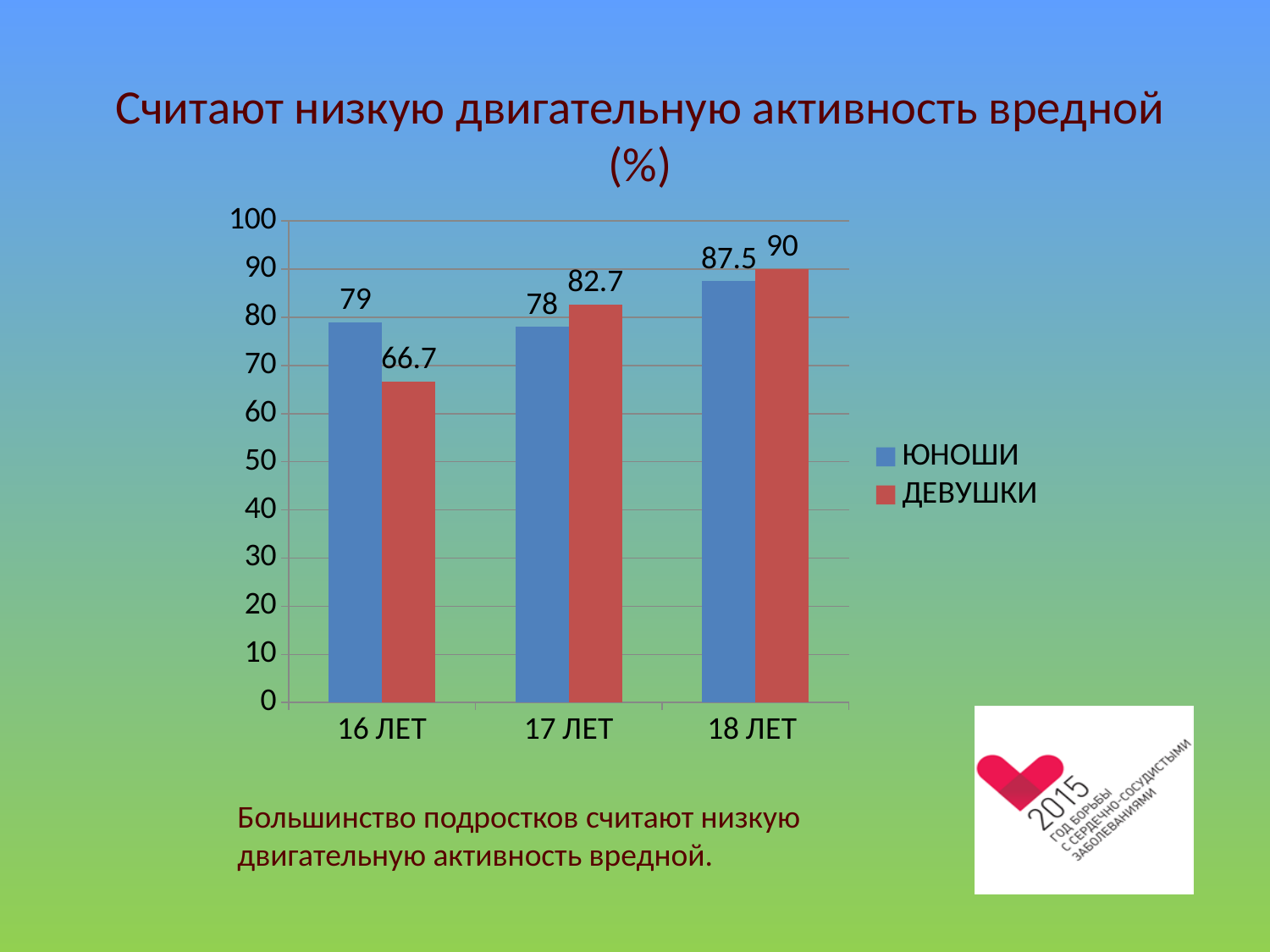
At 18 ЛЕТ, which is larger: the value for ЮНОШИ or for ДЕВУШКИ? ДЕВУШКИ Which age group has the lowest value for ДЕВУШКИ? 16 ЛЕТ What kind of chart is shown on the slide? bar chart Do the ДЕВУШКИ values rise or fall from 16 ЛЕТ to 18 ЛЕТ? rise What is the value for ЮНОШИ at 16 ЛЕТ? 79 Which age group has the highest value for ДЕВУШКИ? 18 ЛЕТ How many age groups are shown on the x axis? 3 What is the difference between the ЮНОШИ and ДЕВУШКИ values at 16 ЛЕТ? 12.3 What is the value for ДЕВУШКИ at 17 ЛЕТ? 82.7 Is the value for ДЕВУШКИ at 16 ЛЕТ greater or less than 70? less What is the value for ДЕВУШКИ at 18 ЛЕТ? 90 How many series does the legend list? 2